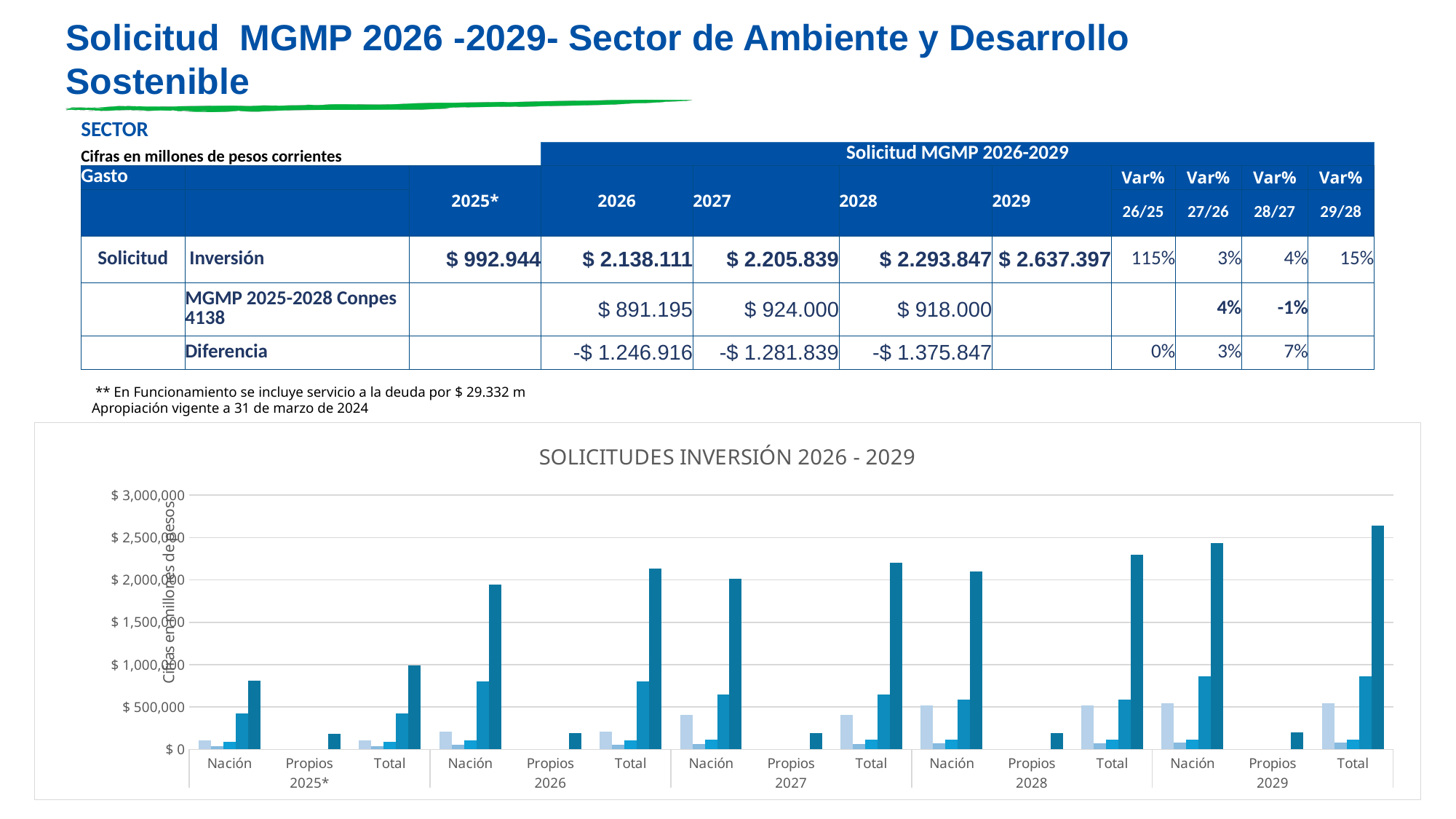
Which is larger: the tallest bar in the Total group for 2029 or the tallest bar in the Total group for 2025*? Total 2029 How many category groups (Nación, Propios, Total across all years) are shown on the x axis? 15 Is the tallest bar in the Nación group for 2026 greater or less than $ 1,500,000? greater Do the tallest bars in the Total groups rise or fall from 2025* to 2029? rise Is the tallest bar in the Propios group for 2028 greater or less than $ 500,000? less Is the tallest bar in the Total group for 2029 greater or less than $ 2,500,000? greater What is the label on the vertical axis of the chart? Cifras en millones de pesos How many years are shown along the x axis of the chart? 5 What type of chart is shown on the slide? bar chart Which year has the tallest bar in its Total group? 2029 What is the title of the chart? SOLICITUDES INVERSIÓN 2026 - 2029